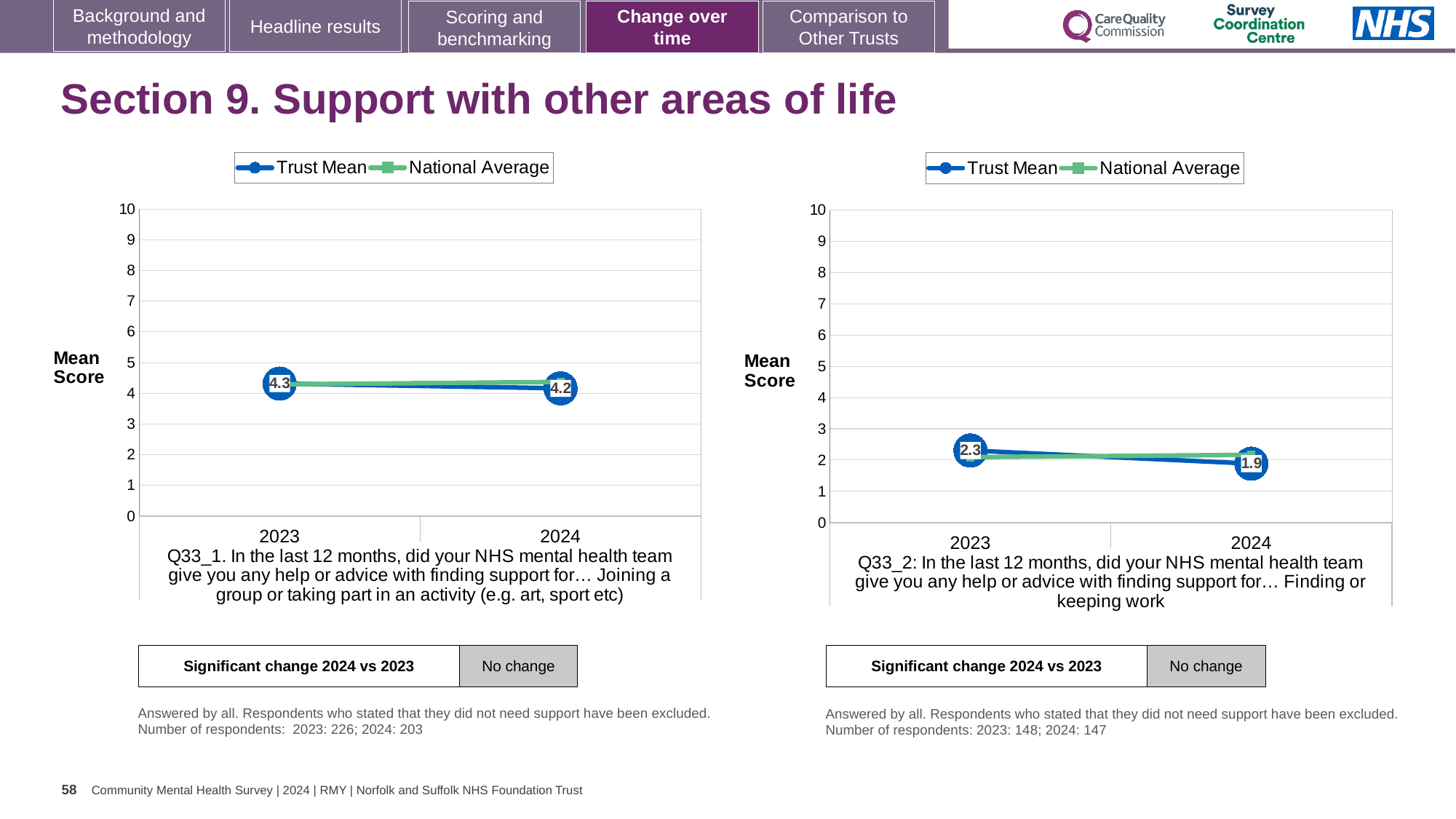
On the right chart (Q33_2), what is the Trust Mean for 2024? 1.9 On the right chart (Q33_2), by how much did the Trust Mean change from 2023 to 2024? 0.4 On the left chart (Q33_1), what is the Trust Mean for 2024? 4.2 On the left chart (Q33_1), what is the Trust Mean for 2023? 4.3 How many series does the legend of the left chart list? 2 How many years are plotted on the x axis of the left chart (Q33_1)? 2 On the right chart (Q33_2), is the Trust Mean for 2024 greater or less than 2? less On the left chart (Q33_1), by how much did the Trust Mean change from 2023 to 2024? 0.1 What kind of chart is the right chart (Q33_2)? line chart On the right chart (Q33_2), does the Trust Mean rise or fall from 2023 to 2024? fall On the right chart (Q33_2), what is the Trust Mean for 2023? 2.3 On the left chart (Q33_1), is the Trust Mean for 2023 greater or less than 5? less